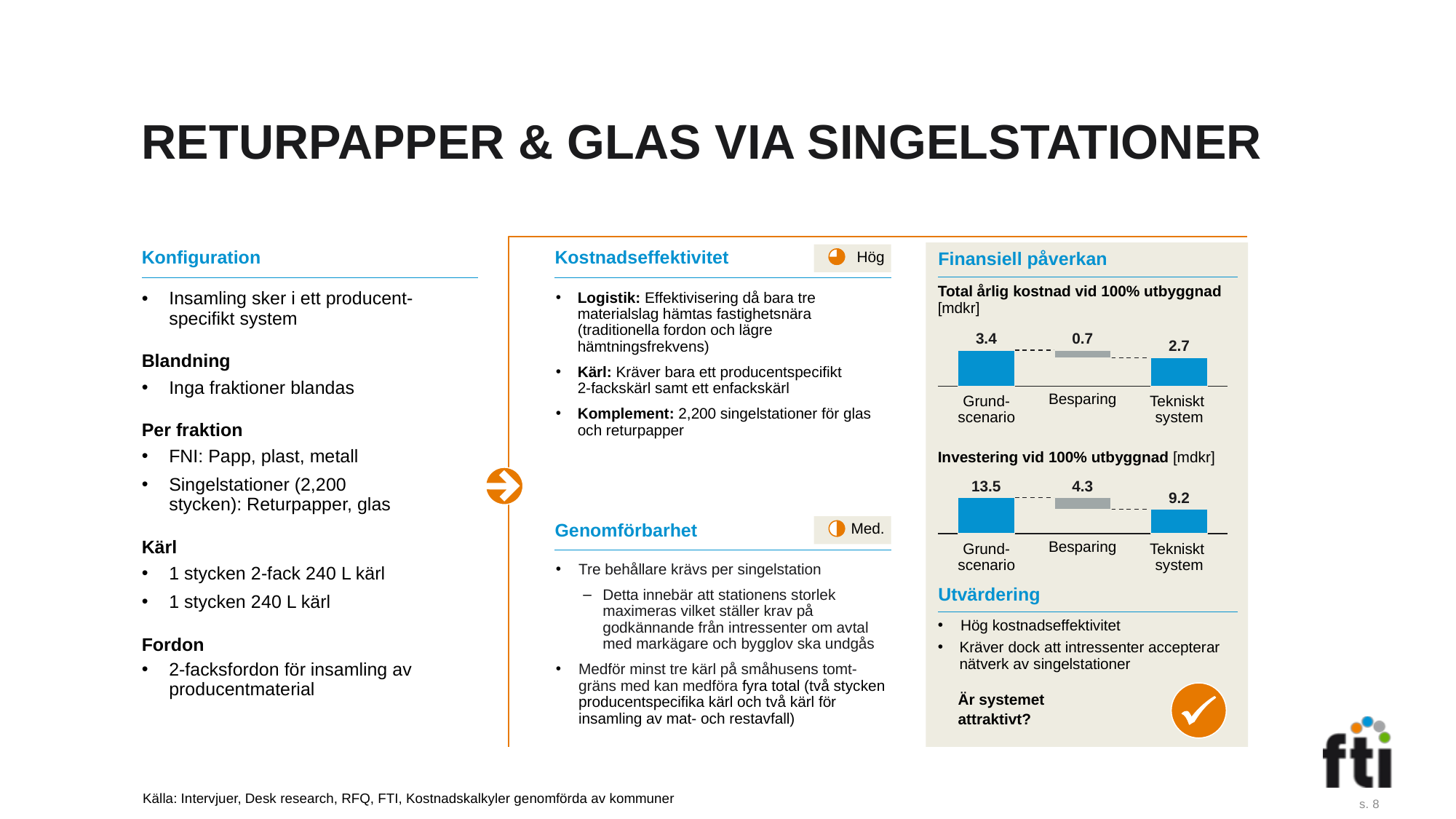
How many categories are shown in the 'Investering vid 100% utbyggnad' chart? 3 What unit is shown for the values in the 'Total årlig kostnad vid 100% utbyggnad' chart? mdkr In the 'Investering vid 100% utbyggnad' chart, what is the difference between Grund-scenario and Tekniskt system? 4.3 In the 'Total årlig kostnad vid 100% utbyggnad' chart, what is the value for Besparing? 0.7 In the 'Investering vid 100% utbyggnad' chart, which category has the lowest value? Besparing In the 'Total årlig kostnad vid 100% utbyggnad' chart, which category has the highest value? Grund-scenario In the 'Investering vid 100% utbyggnad' chart, what is the value for Tekniskt system? 9.2 In the 'Total årlig kostnad vid 100% utbyggnad' chart, what is the value for Tekniskt system? 2.7 In the 'Total årlig kostnad vid 100% utbyggnad' chart, which is larger, Grund-scenario or Tekniskt system? Grund-scenario In the 'Investering vid 100% utbyggnad' chart, what is the value for Besparing? 4.3 In the 'Total årlig kostnad vid 100% utbyggnad' chart, what is the value for Grund-scenario? 3.4 In the 'Investering vid 100% utbyggnad' chart, what is the value for Grund-scenario? 13.5